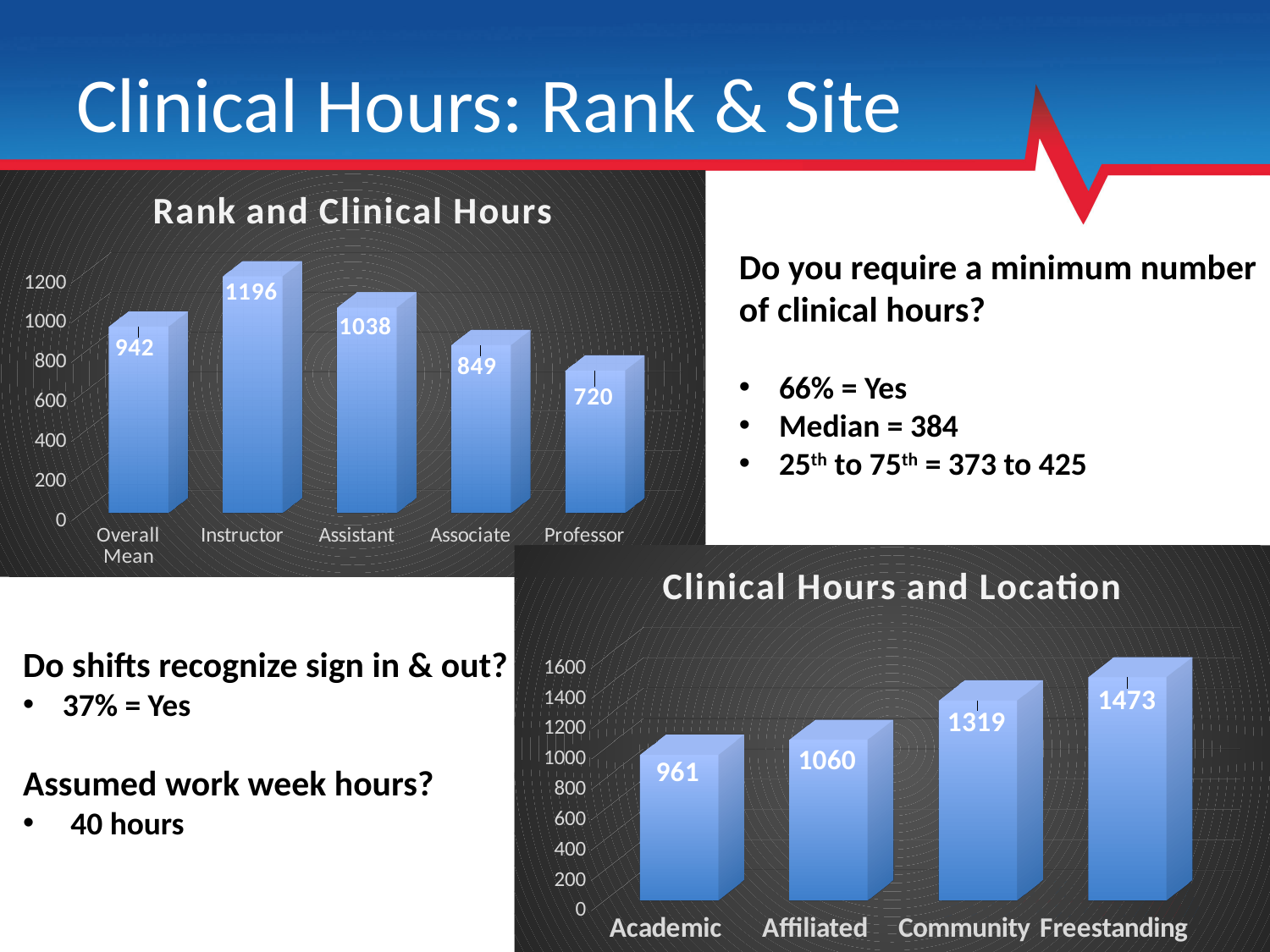
What kind of chart is the 'Clinical Hours and Location' chart? bar chart In the 'Rank and Clinical Hours' chart, what is the difference between the Assistant and Associate values? 189 In the 'Rank and Clinical Hours' chart, which category has the highest value? Instructor In the 'Rank and Clinical Hours' chart, what is the value for Professor? 720 In the 'Rank and Clinical Hours' chart, which category has the lowest value? Professor In the 'Clinical Hours and Location' chart, do the values rise or fall from left to right? rise In the 'Clinical Hours and Location' chart, what is the difference between Freestanding and Academic? 512 In the 'Clinical Hours and Location' chart, what is the value for Community? 1319 In the 'Clinical Hours and Location' chart, which category has the highest value? Freestanding In the 'Rank and Clinical Hours' chart, how many categories are shown? 5 In the 'Rank and Clinical Hours' chart, what is the value for Instructor? 1196 In the 'Clinical Hours and Location' chart, which is larger, Academic or Affiliated? Affiliated